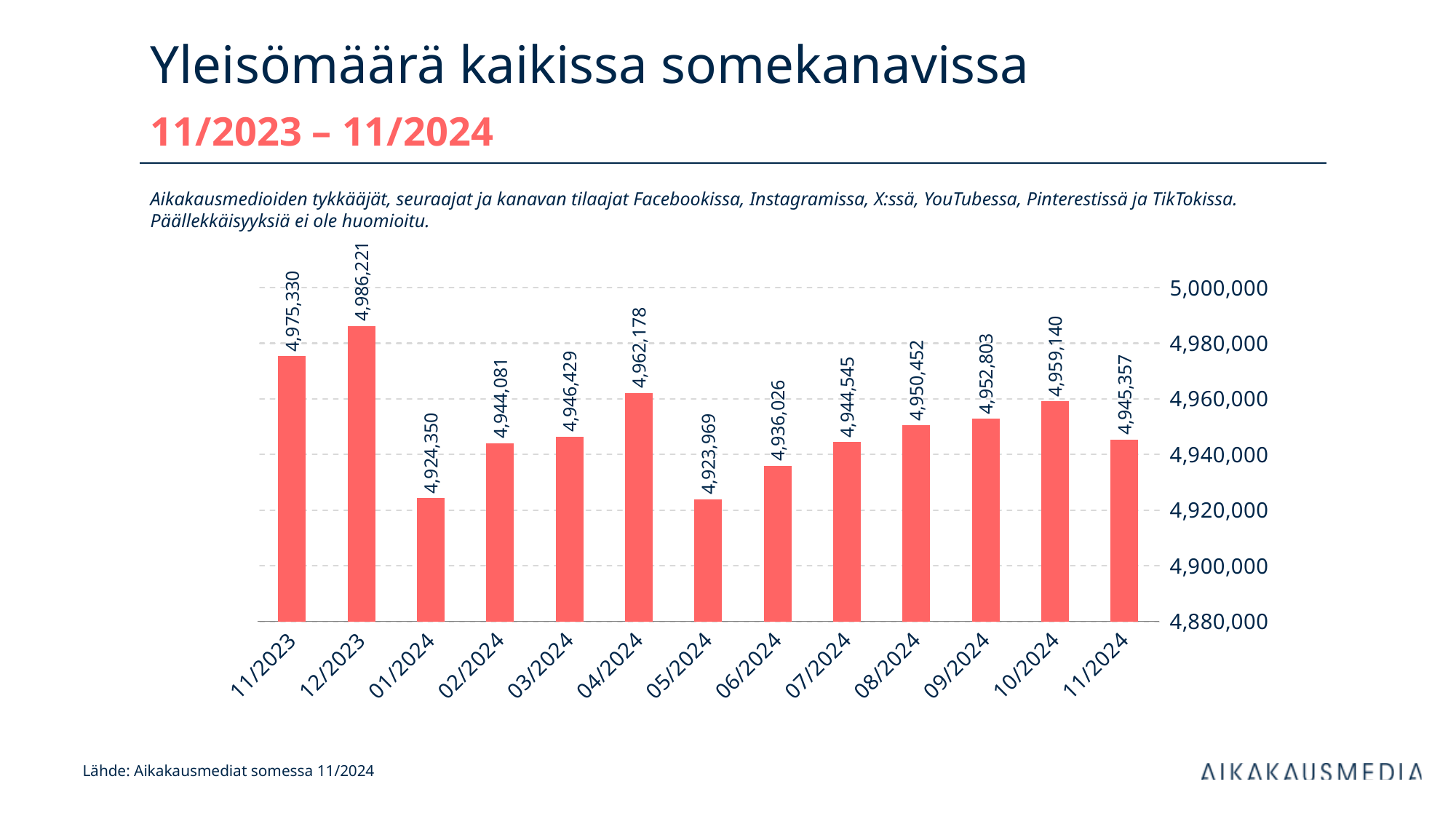
What is the value for 05/2024? 4,923,969 What is the title of the chart on the slide? Yleisömäärä kaikissa somekanavissa Which month has the highest value? 12/2023 What is the value for 12/2023? 4,986,221 What is the difference between the values for 11/2023 and 11/2024? 29,973 What is the difference between the values for 12/2023 and 11/2023? 10,891 Which month has the lowest value? 05/2024 Which is larger, the value for 04/2024 or the value for 10/2024? 04/2024 What is the value for 11/2024? 4,945,357 What kind of chart is shown on the slide? bar chart Is the value for 01/2024 greater or less than 4,940,000? less How many months are shown on the x axis? 13